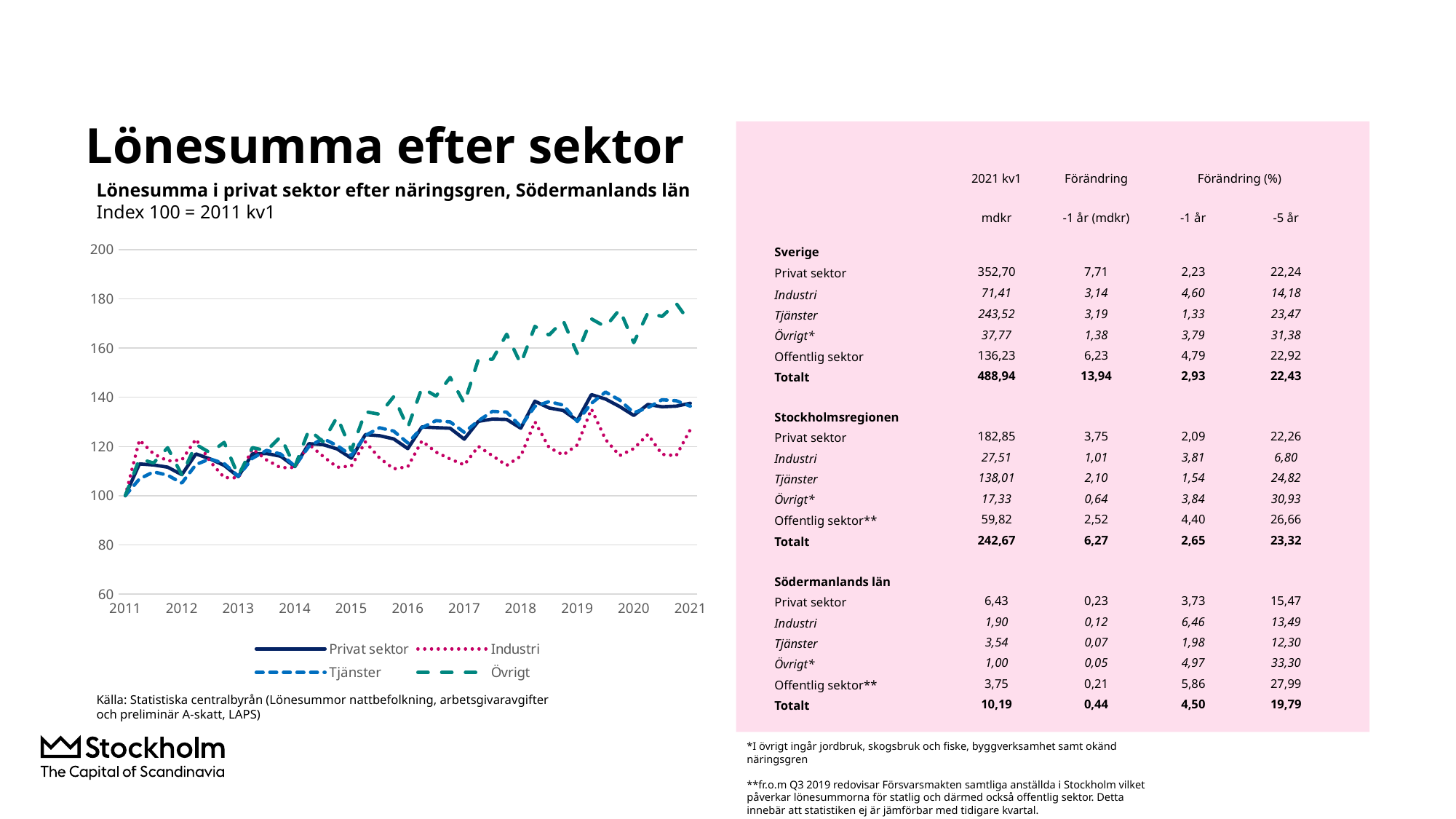
Does the Övrigt series generally rise or fall from 2011 to 2021? Rise Is the value for Privat sektor in 2021 greater or less than 120? greater Which series are listed in the chart legend? Privat sektor, Industri, Tjänster, Övrigt What kind of chart is shown on the slide? Line chart Is the value for Övrigt in 2021 greater or less than 160? greater Which is larger in 2021, Övrigt or Industri? Övrigt Is the value for Industri in 2021 greater or less than 140? less Which series has the highest value at the end of the chart in 2021? Övrigt Which series has the lowest value at the end of the chart in 2021? Industri What is the chart's title? Lönesumma i privat sektor efter näringsgren, Södermanlands län What index value do all series start at in 2011? 100 How many series does the chart legend list? 4